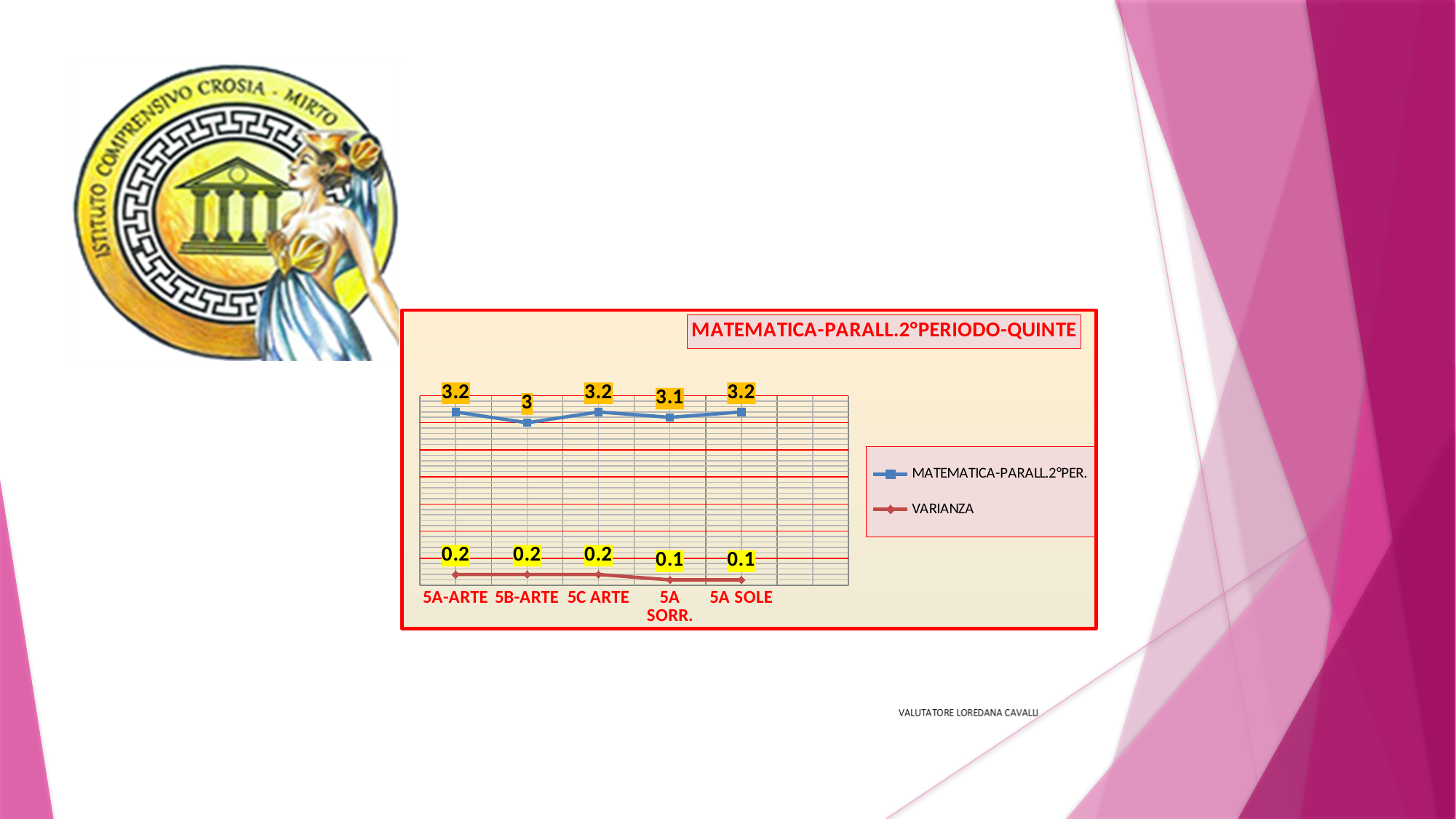
What is the VARIANZA value for 5A SORR.? 0.1 What is the VARIANZA value for 5C ARTE? 0.2 What is the title of the chart? MATEMATICA-PARALL.2°PERIODO-QUINTE What is the difference between the VARIANZA values for 5A-ARTE and 5A SOLE? 0.1 Which category has the lowest MATEMATICA-PARALL.2°PER. value? 5B-ARTE What is the difference between the MATEMATICA-PARALL.2°PER. values for 5A-ARTE and 5B-ARTE? 0.2 What is the MATEMATICA-PARALL.2°PER. value for 5A SORR.? 3.1 How many categories are shown on the x axis? 5 How many series does the legend list? 2 Which is larger, the MATEMATICA-PARALL.2°PER. value for 5A SORR. or for 5A SOLE? 5A SOLE What kind of chart is shown? line chart What is the MATEMATICA-PARALL.2°PER. value for 5B-ARTE? 3